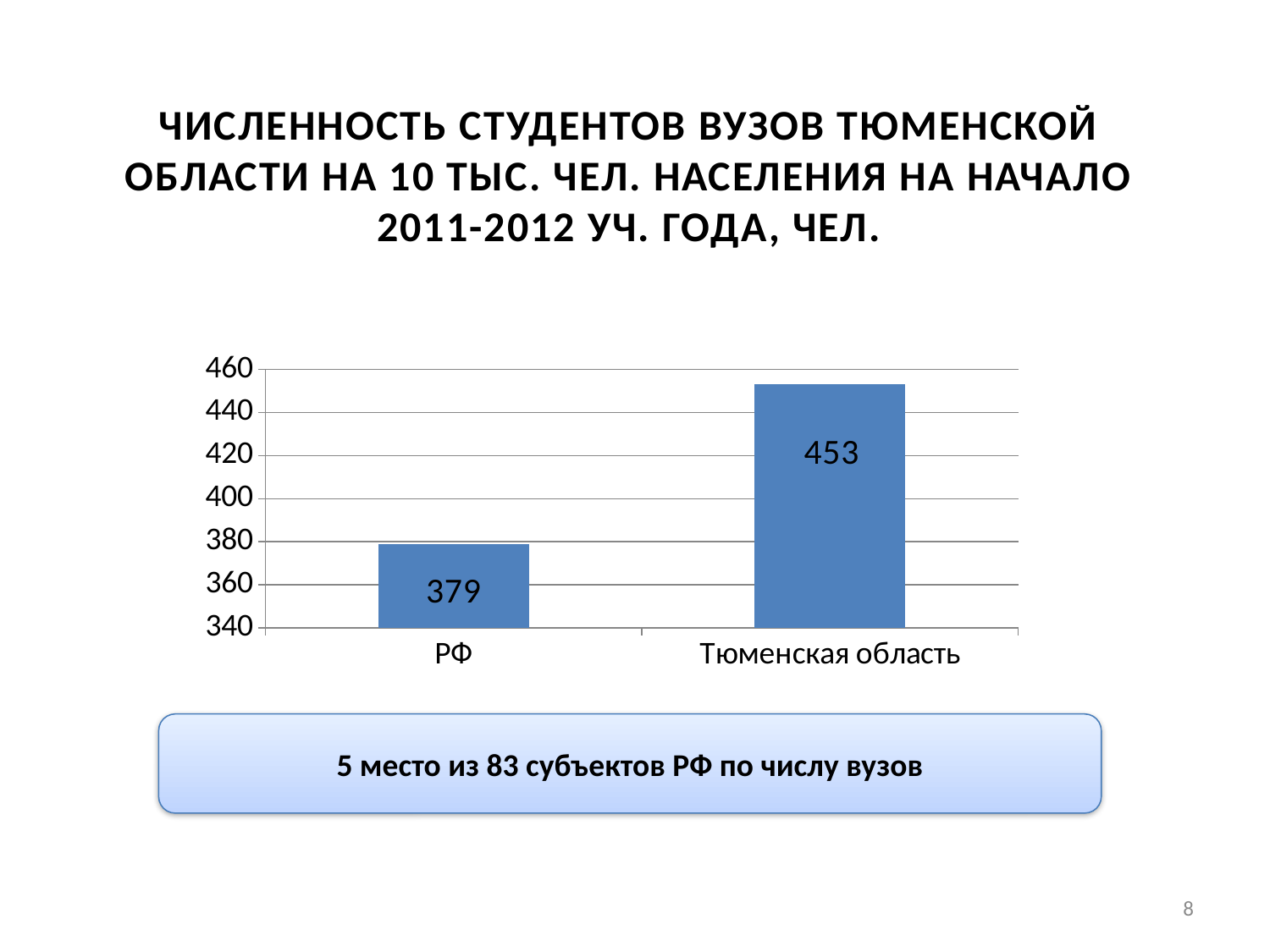
What is the lowest value shown on the vertical axis? 340 Is the value for Тюменская область greater or less than 440? greater Is the value for РФ greater or less than 400? less Which category has the highest value? Тюменская область What is the difference between the values for Тюменская область and РФ? 74 What kind of chart is shown on the slide? bar chart Which category has the lowest value? РФ What is the highest value shown on the vertical axis? 460 What is the value for РФ? 379 Which is larger, the value for РФ or the value for Тюменская область? Тюменская область How many categories are shown on the chart? 2 What is the value for Тюменская область? 453